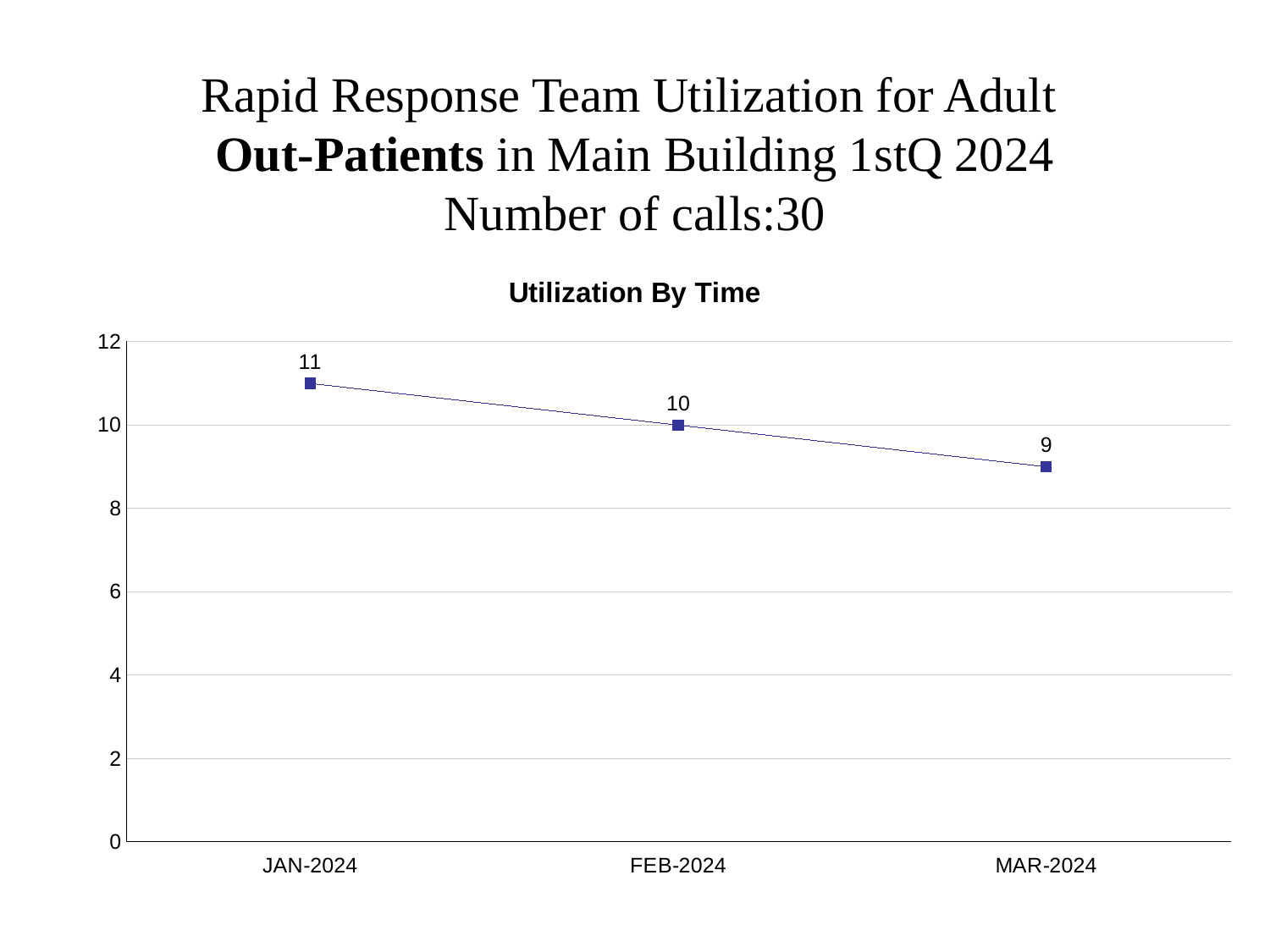
What kind of chart is shown? line chart Which month has the highest value? JAN-2024 How many data points are plotted on the chart? 3 Is the value for MAR-2024 greater or less than 8? greater Which month has the lowest value? MAR-2024 Which is larger, the value for FEB-2024 or the value for MAR-2024? FEB-2024 What is the title of the chart? Utilization By Time What is the difference between the values for JAN-2024 and MAR-2024? 2 What is the value for FEB-2024? 10 What is the value for JAN-2024? 11 Do the values rise or fall from JAN-2024 to MAR-2024? fall What is the value for MAR-2024? 9